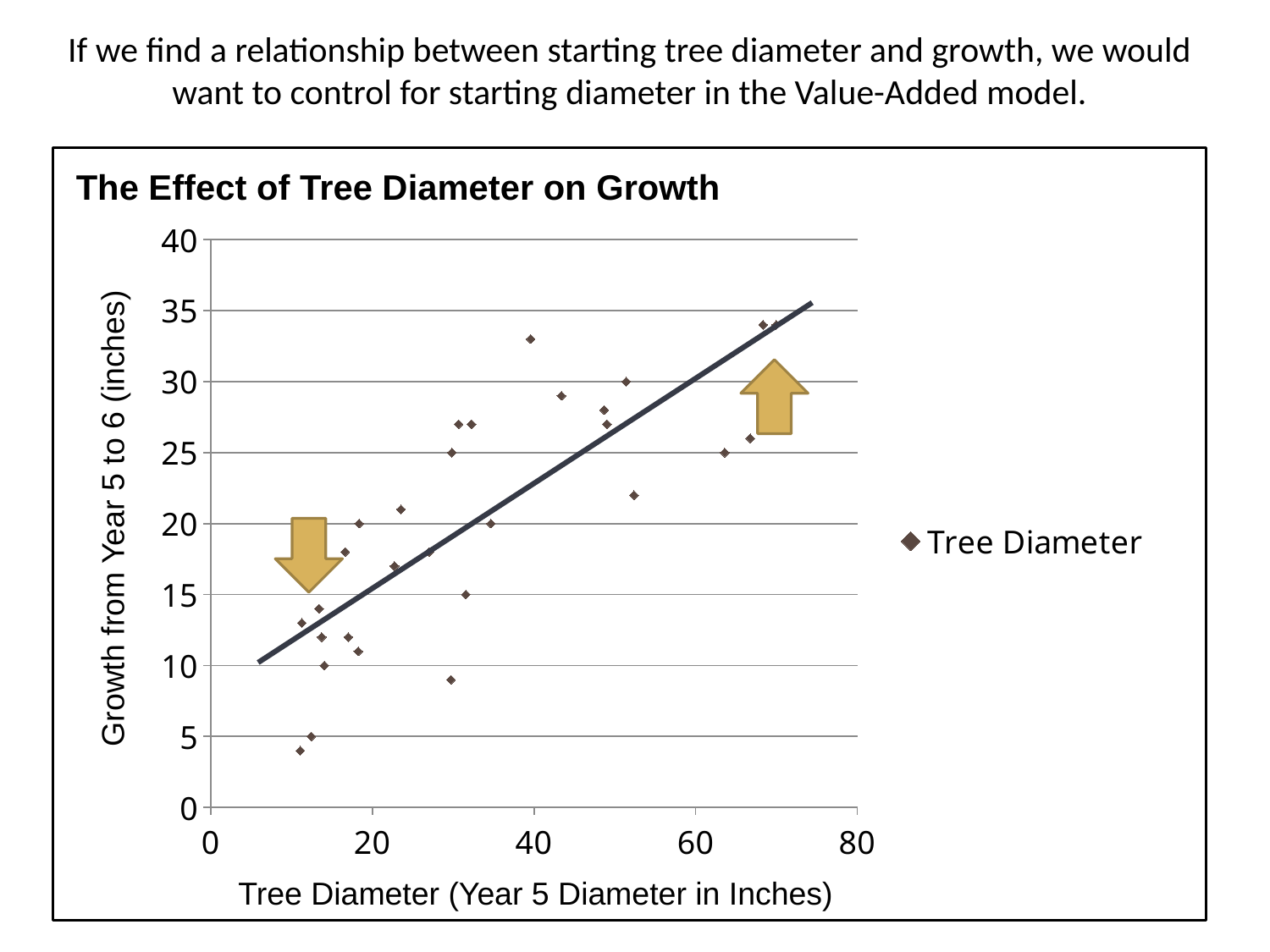
What is the title of the chart? The Effect of Tree Diameter on Growth Does growth generally rise or fall as tree diameter increases along the x axis? Rise Is the growth for the trees with the largest diameter (around 70 inches) greater or less than 30? greater What is the name of the series shown in the legend? Tree Diameter Is the growth for the tree with the highest growth value greater or less than 30? greater How many series does the legend list? 1 Is the growth for the tree with the lowest growth value greater or less than 5? less What kind of chart is shown on the slide? Scatter chart